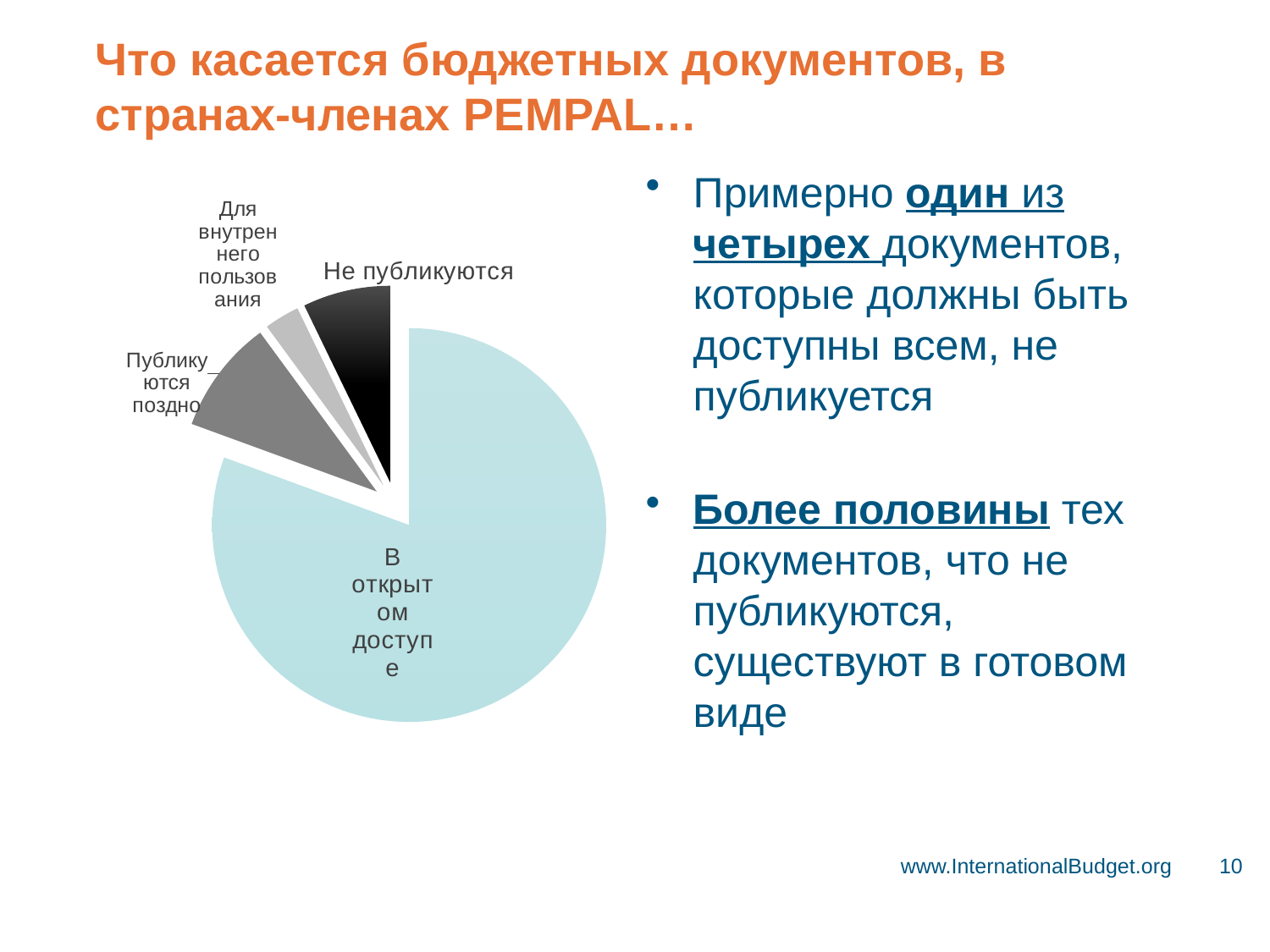
Does the "В открытом доступе" slice take up more or less than half of the pie? More How many slices does the pie chart have? 4 Which category has the largest slice of the pie chart? В открытом доступе What kind of chart is shown on the slide? Pie chart What colour is the largest slice of the pie chart? Light blue Which slice is larger: "Публикуются поздно" or "Не публикуются"? Публикуются поздно What colour is the "Не публикуются" slice? Black Which category has the smallest slice of the pie chart? Для внутреннего пользования Which slice is larger: "Не публикуются" or "Для внутреннего пользования"? Не публикуются Which slice is larger: "В открытом доступе" or "Публикуются поздно"? В открытом доступе